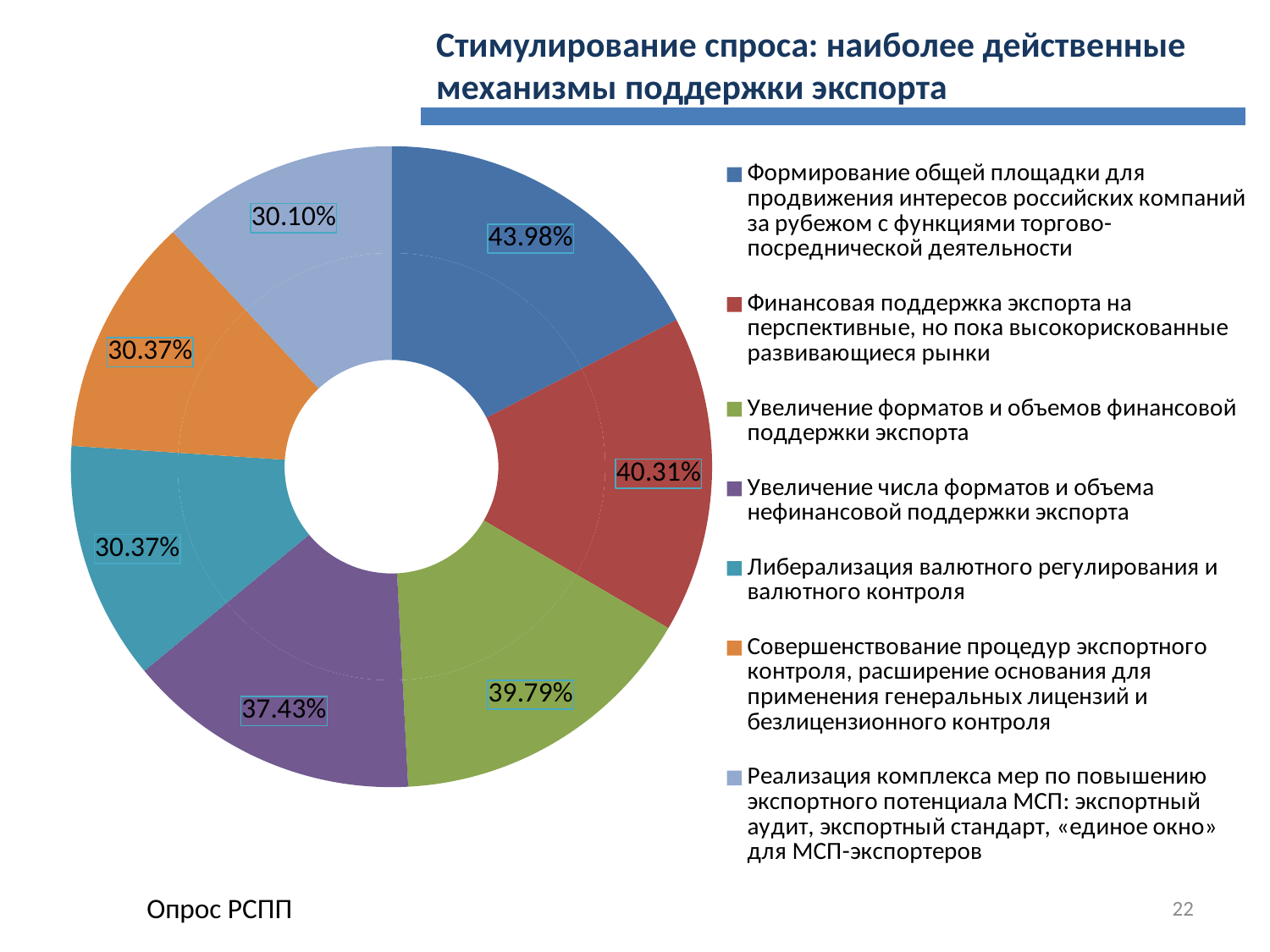
What value is shown for 'Увеличение форматов и объемов финансовой поддержки экспорта'? 39.79% What value is shown for 'Финансовая поддержка экспорта на перспективные, но пока высокорискованные развивающиеся рынки'? 40.31% How many slices does the chart have? 7 What is the difference between the values for 'Формирование общей площадки...' (43.98%) and 'Финансовая поддержка экспорта...' (40.31%)? 3.67 percentage points What value is shown for the slice 'Формирование общей площадки для продвижения интересов российских компаний за рубежом с функциями торгово-посреднической деятельности'? 43.98% What value is shown for 'Либерализация валютного регулирования и валютного контроля'? 30.37% What value is shown for 'Реализация комплекса мер по повышению экспортного потенциала МСП: экспортный аудит, экспортный стандарт, «единое окно» для МСП-экспортеров'? 30.10% Which category has the highest value in the chart? Формирование общей площадки для продвижения интересов российских компаний за рубежом с функциями торгово-посреднической деятельности What kind of chart is shown on the slide? doughnut chart What value is shown for 'Увеличение числа форматов и объема нефинансовой поддержки экспорта'? 37.43% What is the title of the slide's chart? Стимулирование спроса: наиболее действенные механизмы поддержки экспорта Which is larger: the value for 'Увеличение числа форматов и объема нефинансовой поддержки экспорта' or for 'Либерализация валютного регулирования и валютного контроля'? Увеличение числа форматов и объема нефинансовой поддержки экспорта